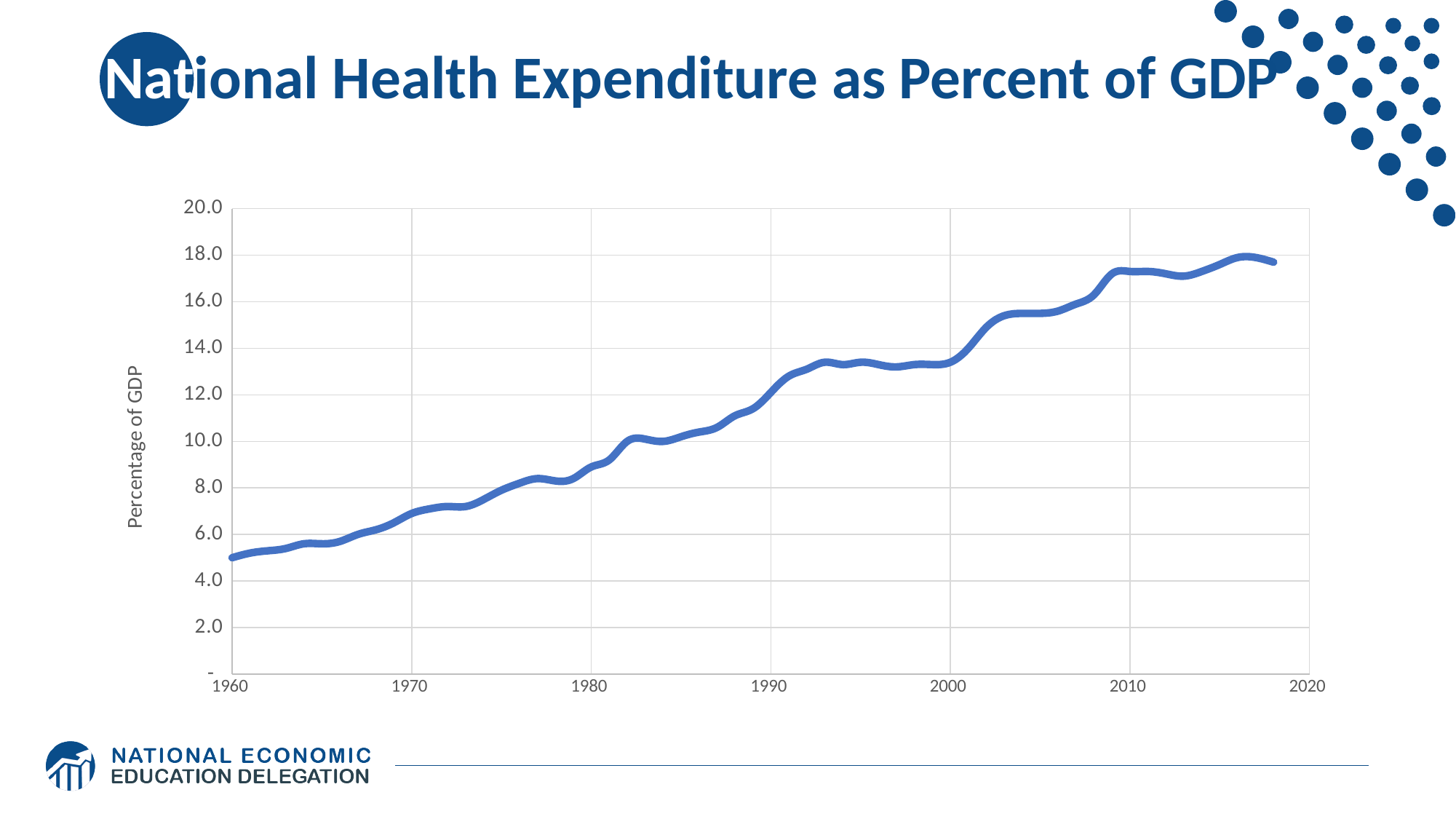
Overall, does the value rise or fall from 1960 to 2020? rise Is the value for 1970 greater or less than 8.0? less What is the title of the chart? National Health Expenditure as Percent of GDP What kind of chart is shown on the slide? line chart Which year has the larger value, 2000 or 2010? 2010 Which year has the larger value, 1980 or 1990? 1990 Is the value for 2010 greater or less than 16.0? greater Is the value for 2000 greater or less than 14.0? less What is the label on the vertical axis? Percentage of GDP